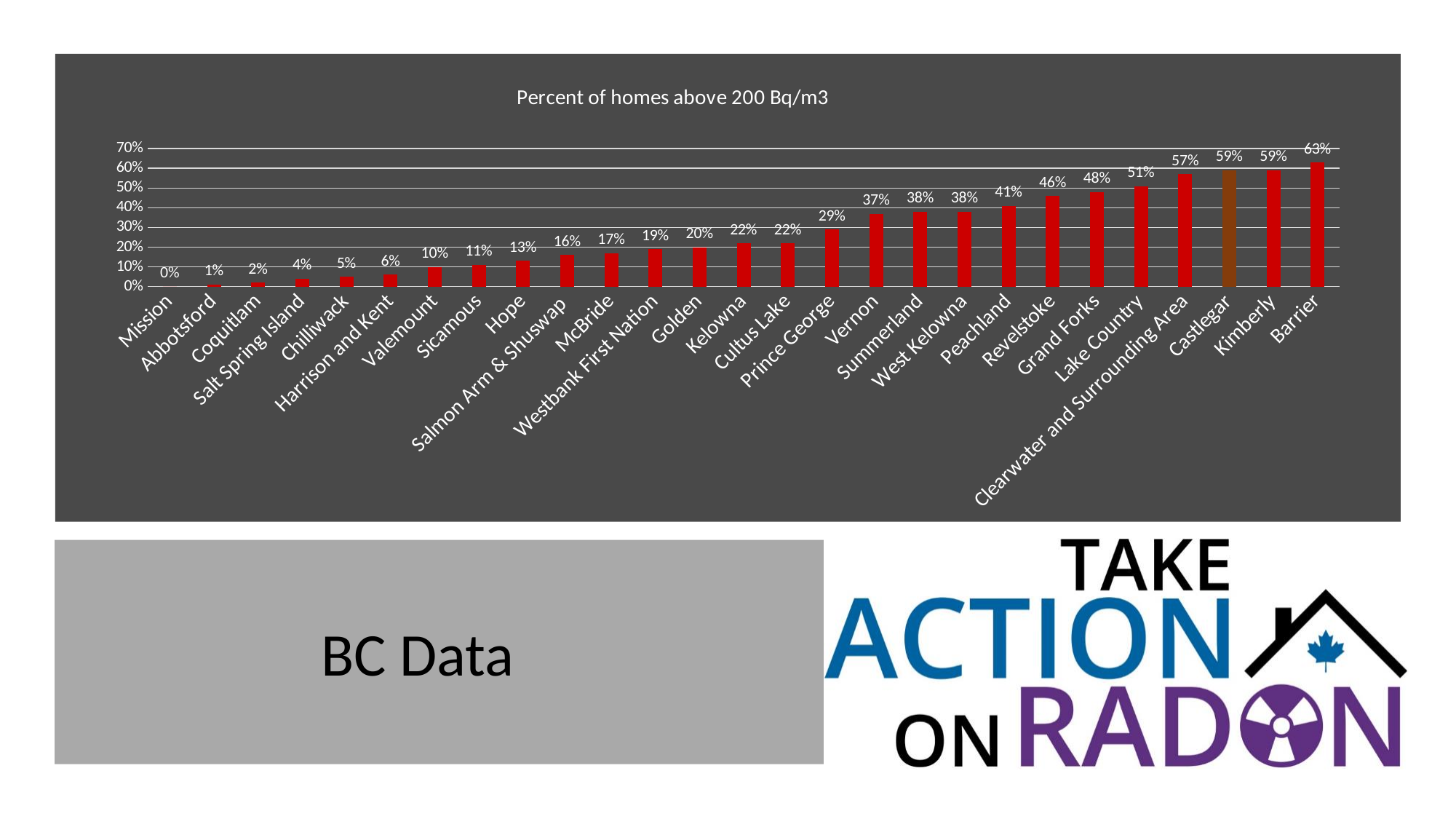
Which community has the lowest percent of homes above 200 Bq/m3? Mission Which has a higher value, Vernon or Peachland? Peachland What is the percent of homes above 200 Bq/m3 for Prince George? 29% What is the title of the chart? Percent of homes above 200 Bq/m3 Do the values generally rise or fall moving from left to right along the x axis? rise What is the value shown for Castlegar? 59% How many communities are shown on the x axis of the chart? 27 What type of chart is shown on the slide? bar chart What is the value shown for Valemount? 10% Which bar is shown in a different colour (brown) from the rest? Castlegar What is the difference between the values for Barrier and Clearwater and Surrounding Area? 6% Which community has the highest percent of homes above 200 Bq/m3? Barrier